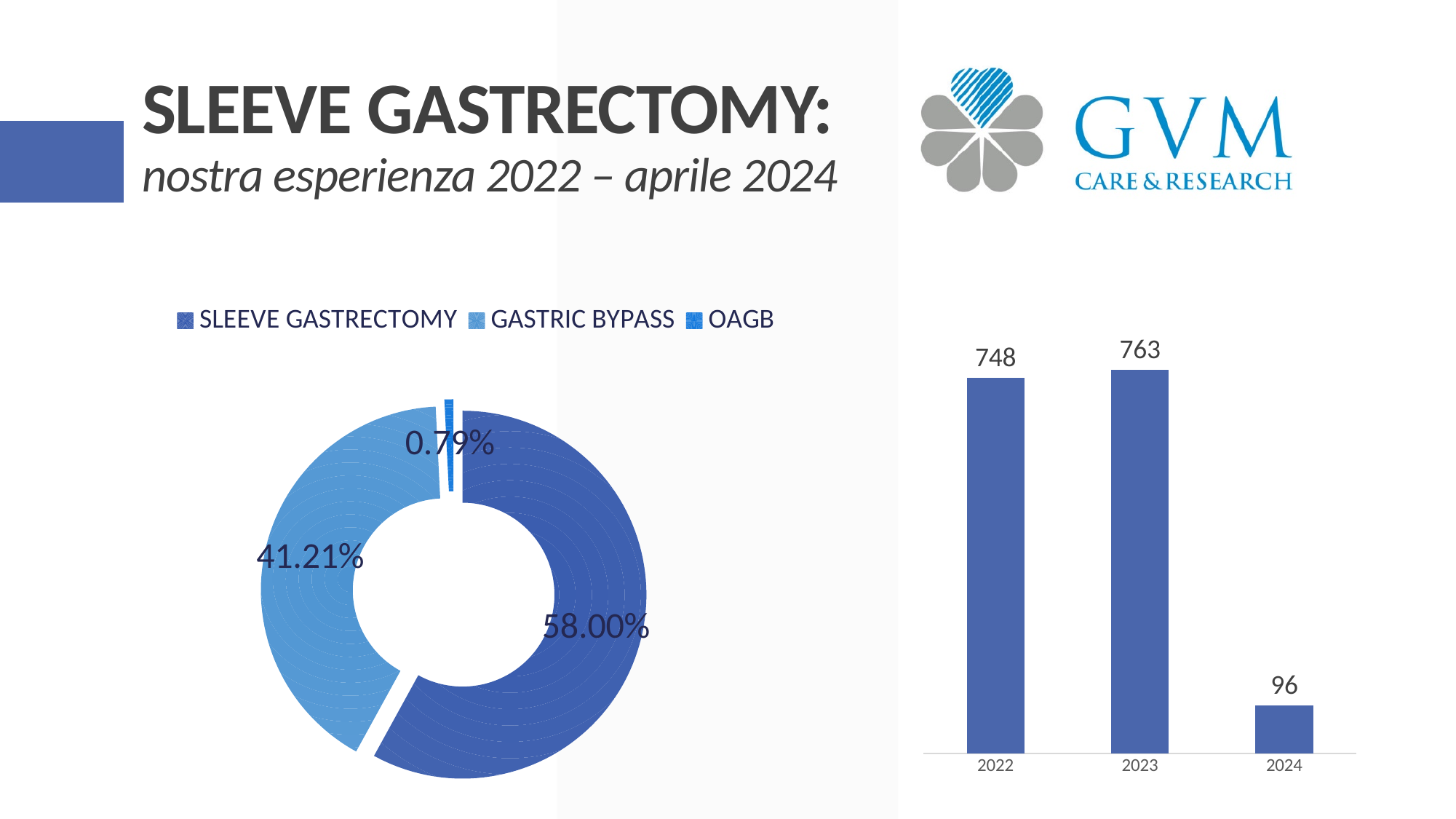
In the doughnut chart on the left, which category has the smallest share? OAGB In the bar chart on the right, what is the difference between the values for 2023 and 2022? 15 In the doughnut chart on the left, what is the difference in percentage points between SLEEVE GASTRECTOMY and GASTRIC BYPASS? 16.79 In the doughnut chart on the left, what share does OAGB have? 0.79% In the doughnut chart on the left, how many entries does the legend list? 3 In the bar chart on the right, what is the value for 2024? 96 In the bar chart on the right, what is the value for 2023? 763 In the doughnut chart on the left, which category has the largest share? SLEEVE GASTRECTOMY In the doughnut chart on the left, what share does SLEEVE GASTRECTOMY have? 58.00% In the doughnut chart on the left, what share does GASTRIC BYPASS have? 41.21% What kind of chart is shown on the right side of the slide? Bar chart In the bar chart on the right, which year has the highest value? 2023